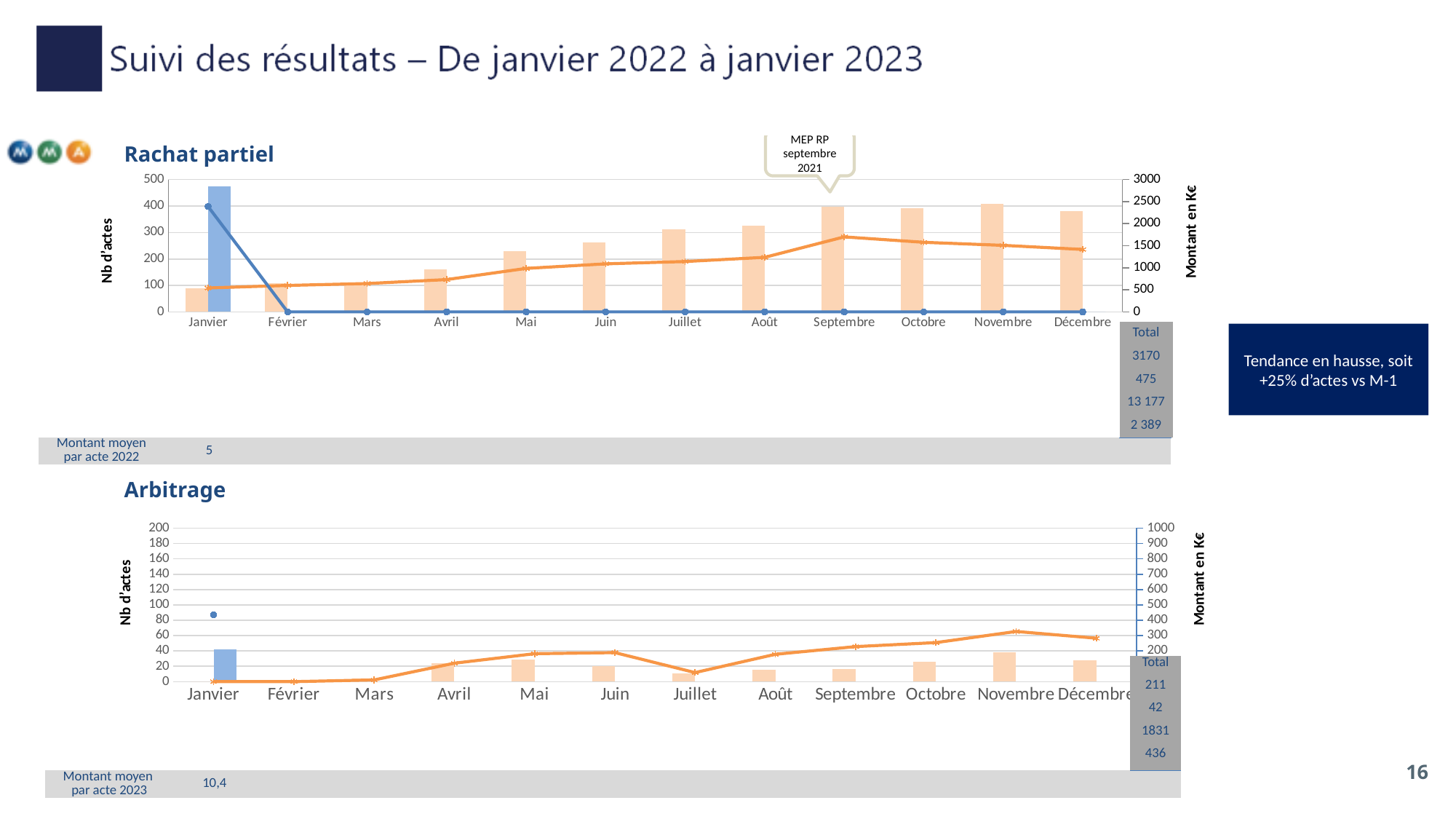
In the 'Rachat partiel' chart, is the orange bar for Avril greater or less than 200? less In the 'Arbitrage' chart, is the blue bar for Janvier greater or less than 60? less What is the label of the right-hand vertical axis of the 'Arbitrage' chart? Montant en K€ In the 'Rachat partiel' chart, in which month does the orange line reach its highest point? Septembre In the 'Rachat partiel' chart, is the orange bar for Septembre greater or less than 300? greater In the 'Rachat partiel' chart, which month does the 'MEP RP septembre 2021' callout point to? Septembre In the 'Arbitrage' chart, which orange bar is taller, Novembre or Juillet? Novembre What kind of chart is the 'Rachat partiel' chart? Combined bar and line chart In the 'Rachat partiel' chart, do the orange bars rise or fall from Janvier to Septembre? rise In the 'Rachat partiel' chart, how many months are shown on the x axis? 12 In the 'Rachat partiel' chart, which month has the tallest bar? Janvier In the 'Arbitrage' chart, in which month does the orange line reach its highest point? Novembre